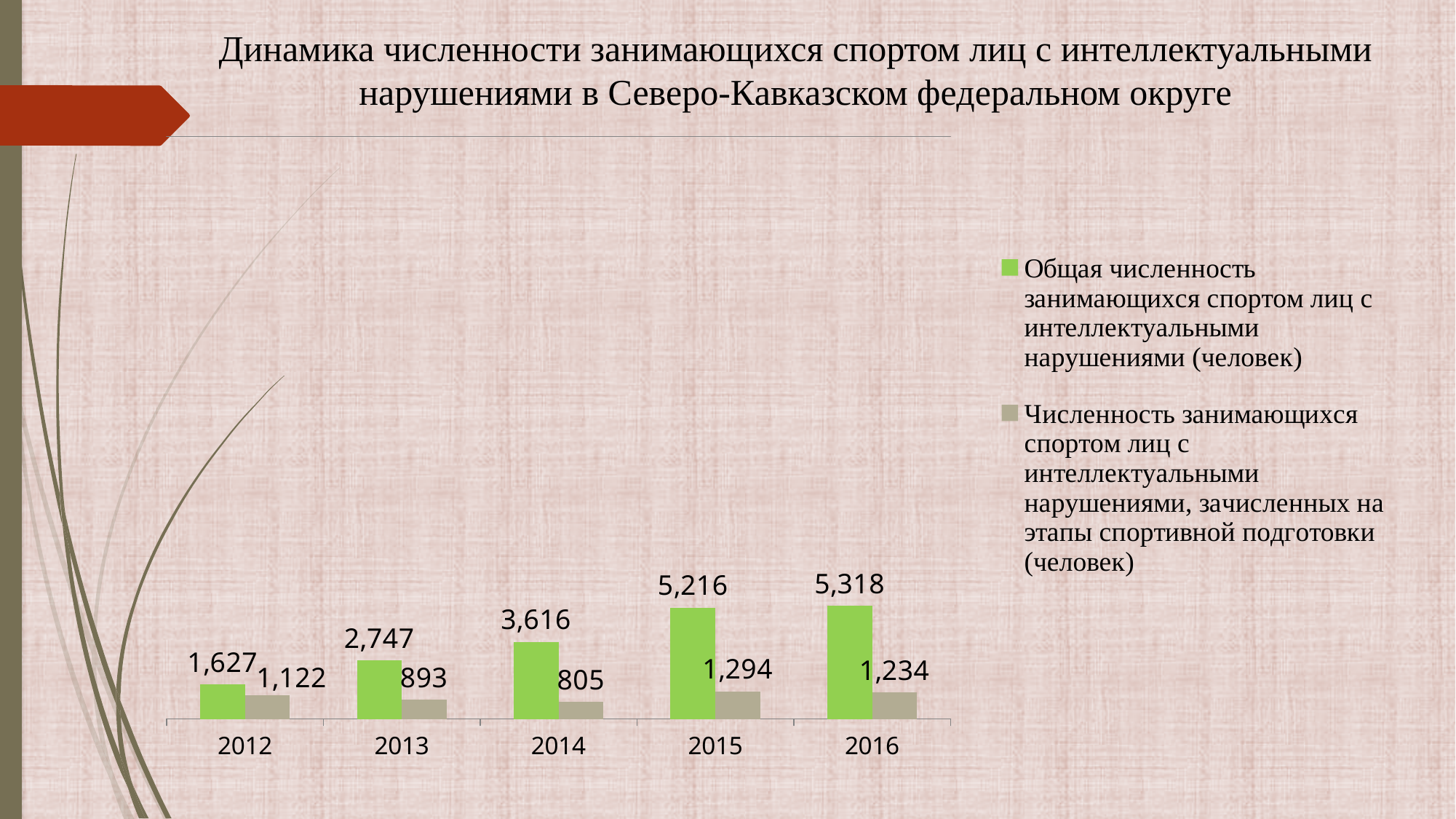
How many years are shown on the x axis of the chart? 5 What is the value of the 'Общая численность занимающихся спортом лиц с интеллектуальными нарушениями (человек)' series for 2016? 5,318 What is the difference between the two series' values in 2012? 505 In which year is the 'Общая численность занимающихся спортом лиц с интеллектуальными нарушениями (человек)' series highest? 2016 In which year is the 'Численность занимающихся спортом лиц с интеллектуальными нарушениями, зачисленных на этапы спортивной подготовки (человек)' series lowest? 2014 What type of chart is shown on the slide? bar chart Does the 'Общая численность занимающихся спортом лиц с интеллектуальными нарушениями (человек)' series rise or fall from 2012 to 2016? rise How many series does the chart's legend list? 2 Which is larger: the 'зачисленных на этапы спортивной подготовки' value for 2015 or for 2016? 2015 What is the value of the 'Численность занимающихся спортом лиц с интеллектуальными нарушениями, зачисленных на этапы спортивной подготовки (человек)' series for 2013? 893 What is the difference between the 'Общая численность' value for 2015 and the 'Общая численность' value for 2014? 1,600 What is the value of the 'Общая численность занимающихся спортом лиц с интеллектуальными нарушениями (человек)' series for 2014? 3,616